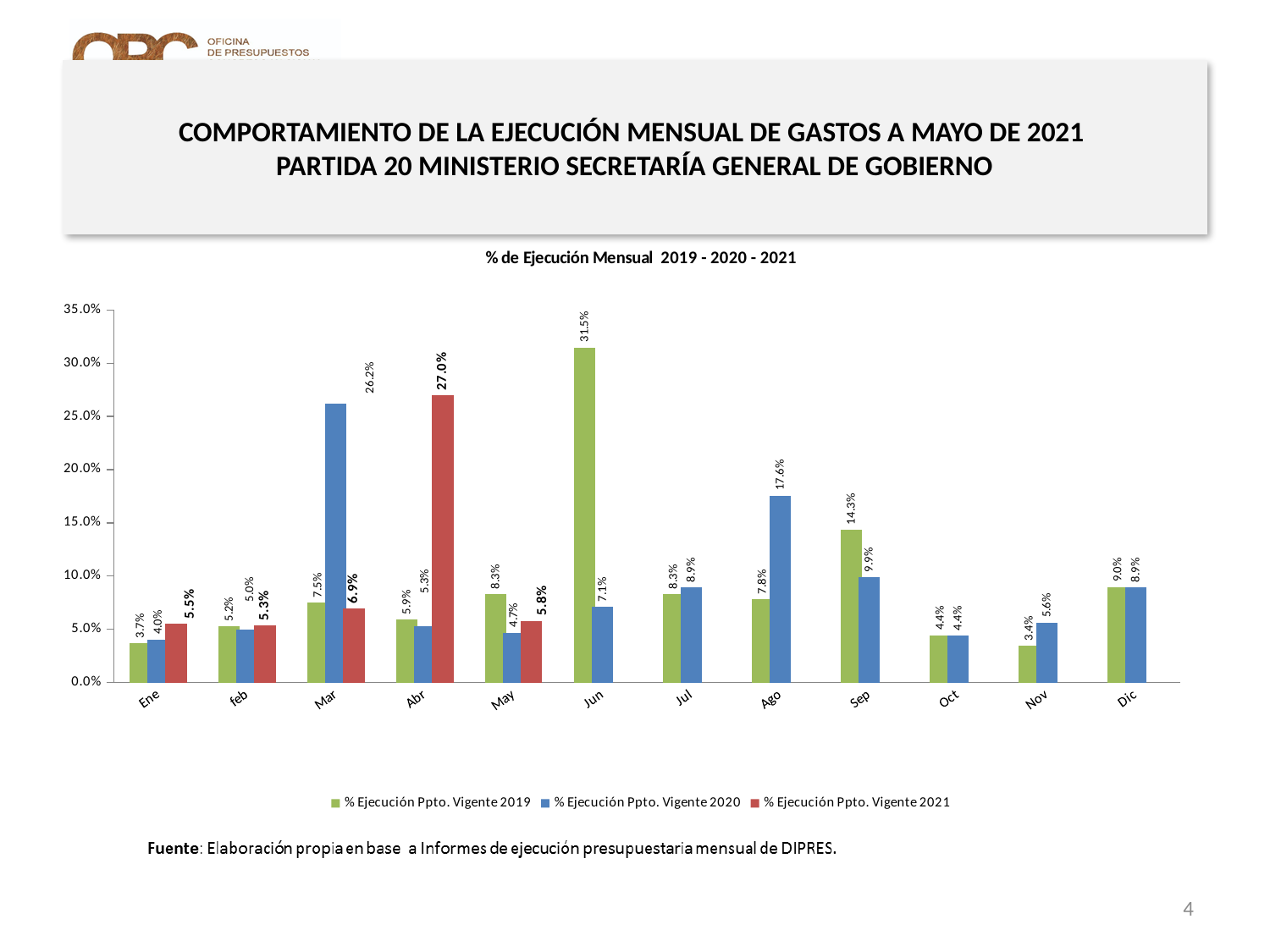
Is the value for % Ejecución Ppto. Vigente 2019 in Jun greater or less than 30.0%? greater What is the value for % Ejecución Ppto. Vigente 2021 in Abr? 27.0% What is the title of the chart? % de Ejecución Mensual 2019 - 2020 - 2021 How many months are shown on the x axis? 12 Which is larger in May: the 2019 value or the 2020 value? 2019 What is the difference between the 2020 and 2019 values in Ago? 9.8% What is the value for % Ejecución Ppto. Vigente 2019 in Sep? 14.3% How many series does the legend list? 3 What kind of chart is shown on the slide? Bar chart In which month is the % Ejecución Ppto. Vigente 2019 series lowest? Nov In which month is the % Ejecución Ppto. Vigente 2019 series highest? Jun What is the value for % Ejecución Ppto. Vigente 2020 in Mar? 26.2%